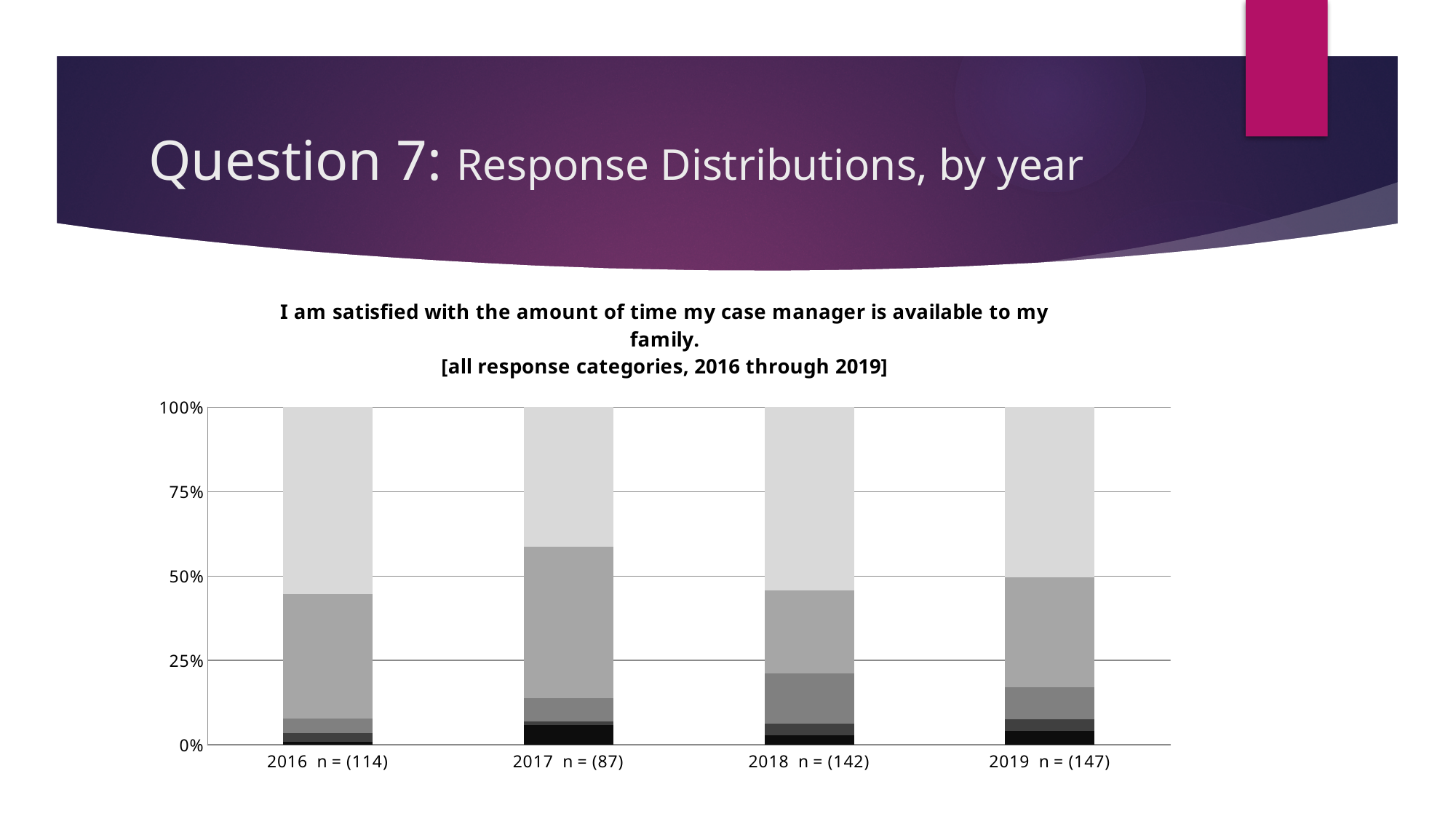
Which year has the smallest lightest-gray (top) segment? 2017 Is the top of the dark-gray segment for 2018 greater or less than 25%? less How many years (categories) are shown on the x axis of the chart? 4 Is the top of the medium-gray segment for 2017 greater or less than 50%? greater What is the sample size (n) shown for 2019? 147 Which year has the smallest sample size (n) in its axis label? 2017 What is the title of the chart? I am satisfied with the amount of time my case manager is available to my family. [all response categories, 2016 through 2019] What kind of chart is shown on the slide? Stacked bar chart Is the top of the medium-gray segment for 2016 greater or less than 50%? less What is the highest value shown on the y axis? 100% Which year has the largest medium-gray segment? 2017 What is the sample size (n) shown for 2017? 87